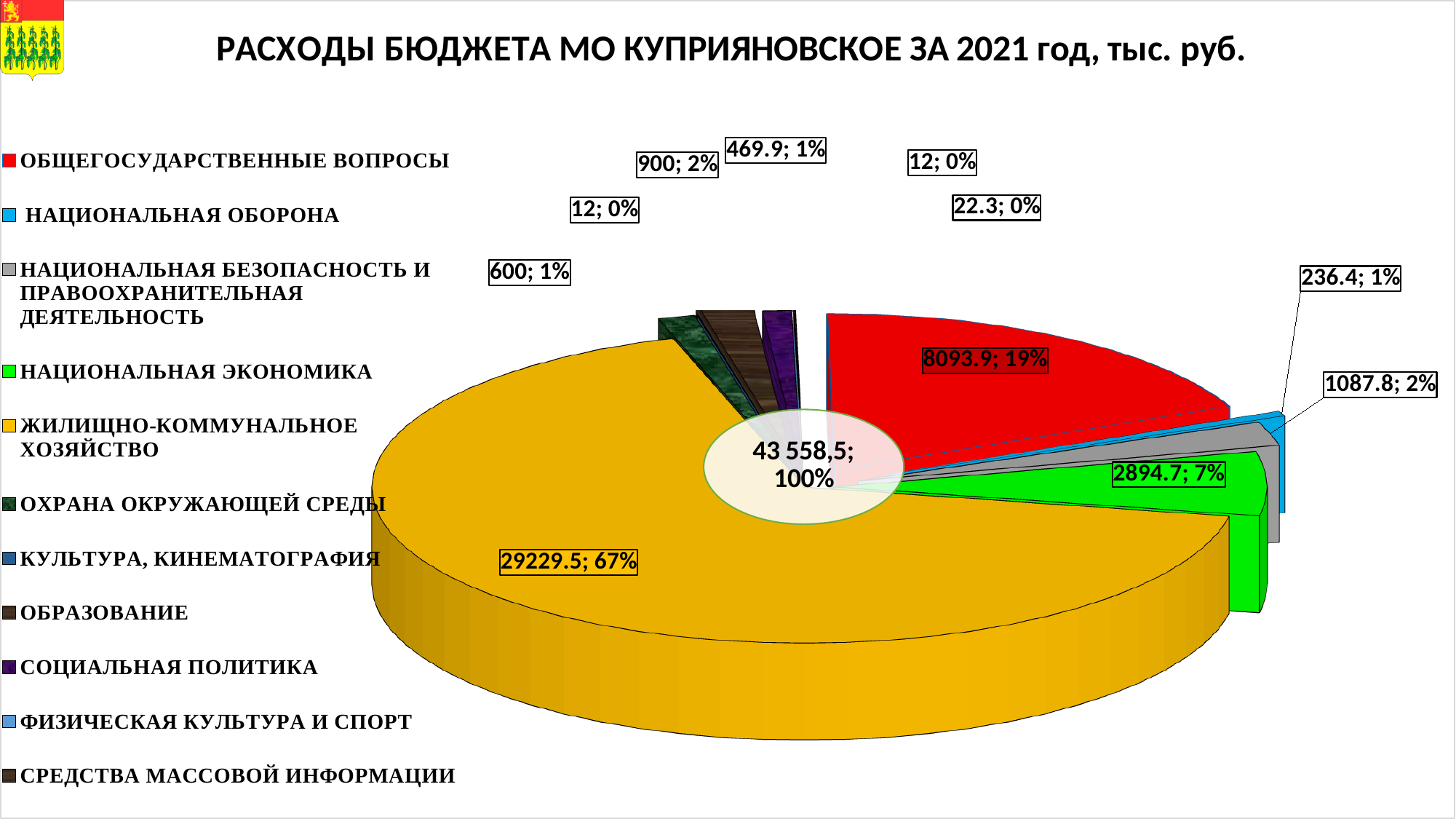
What is the value for НАЦИОНАЛЬНАЯ ЭКОНОМИКА? 2894.7 Which category has the largest slice of the pie? ЖИЛИЩНО-КОММУНАЛЬНОЕ ХОЗЯЙСТВО What total value is shown in the centre of the pie? 43 558,5 What is the value for ЖИЛИЩНО-КОММУНАЛЬНОЕ ХОЗЯЙСТВО? 29229.5 What share of the pie does ОБЩЕГОСУДАРСТВЕННЫЕ ВОПРОСЫ represent? 19% What share of the pie does ЖИЛИЩНО-КОММУНАЛЬНОЕ ХОЗЯЙСТВО represent? 67% What is the title of the chart? РАСХОДЫ БЮДЖЕТА МО КУПРИЯНОВСКОЕ ЗА 2021 год, тыс. руб. How many categories does the legend list? 11 What kind of chart is shown on the slide? pie chart Which is larger, ОБЩЕГОСУДАРСТВЕННЫЕ ВОПРОСЫ or НАЦИОНАЛЬНАЯ ЭКОНОМИКА? ОБЩЕГОСУДАРСТВЕННЫЕ ВОПРОСЫ What is the value for ОБЩЕГОСУДАРСТВЕННЫЕ ВОПРОСЫ? 8093.9 What is the difference between the values for ОБЩЕГОСУДАРСТВЕННЫЕ ВОПРОСЫ and НАЦИОНАЛЬНАЯ ЭКОНОМИКА? 5199.2